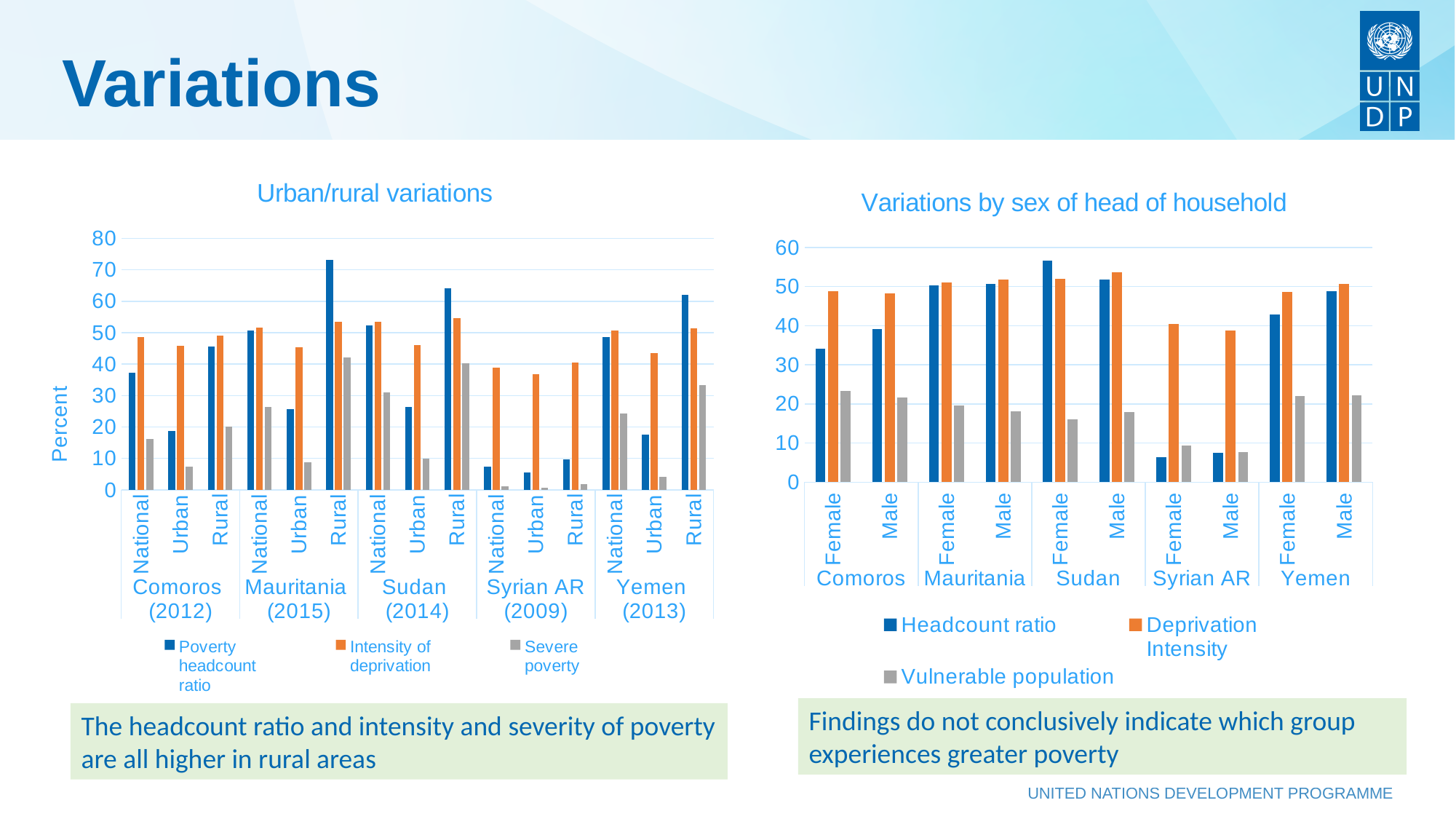
In the 'Urban/rural variations' chart, is the Poverty headcount ratio for Rural Mauritania (2015) greater or less than 70? greater In the 'Variations by sex of head of household' chart, how many bars are plotted for the Headcount ratio series? 10 How many series does the legend of the 'Variations by sex of head of household' chart list? 3 How many series does the legend of the 'Urban/rural variations' chart list? 3 In the 'Urban/rural variations' chart, is the Poverty headcount ratio for Urban Syrian AR (2009) greater or less than 10? less What type of chart is the 'Urban/rural variations' chart? bar chart In the 'Variations by sex of head of household' chart, which is larger for Yemen: the Headcount ratio for Female or for Male? Male In the 'Urban/rural variations' chart, how many countries are shown on the x axis? 5 In the 'Urban/rural variations' chart, which bar has the highest Poverty headcount ratio? Rural, Mauritania (2015) In the 'Variations by sex of head of household' chart, is the Headcount ratio for Female-headed households in Sudan greater or less than 50? greater In the 'Variations by sex of head of household' chart, which bar has the highest Headcount ratio? Female, Sudan In the 'Urban/rural variations' chart, which is larger for Comoros (2012): the Poverty headcount ratio for Urban or for Rural? Rural